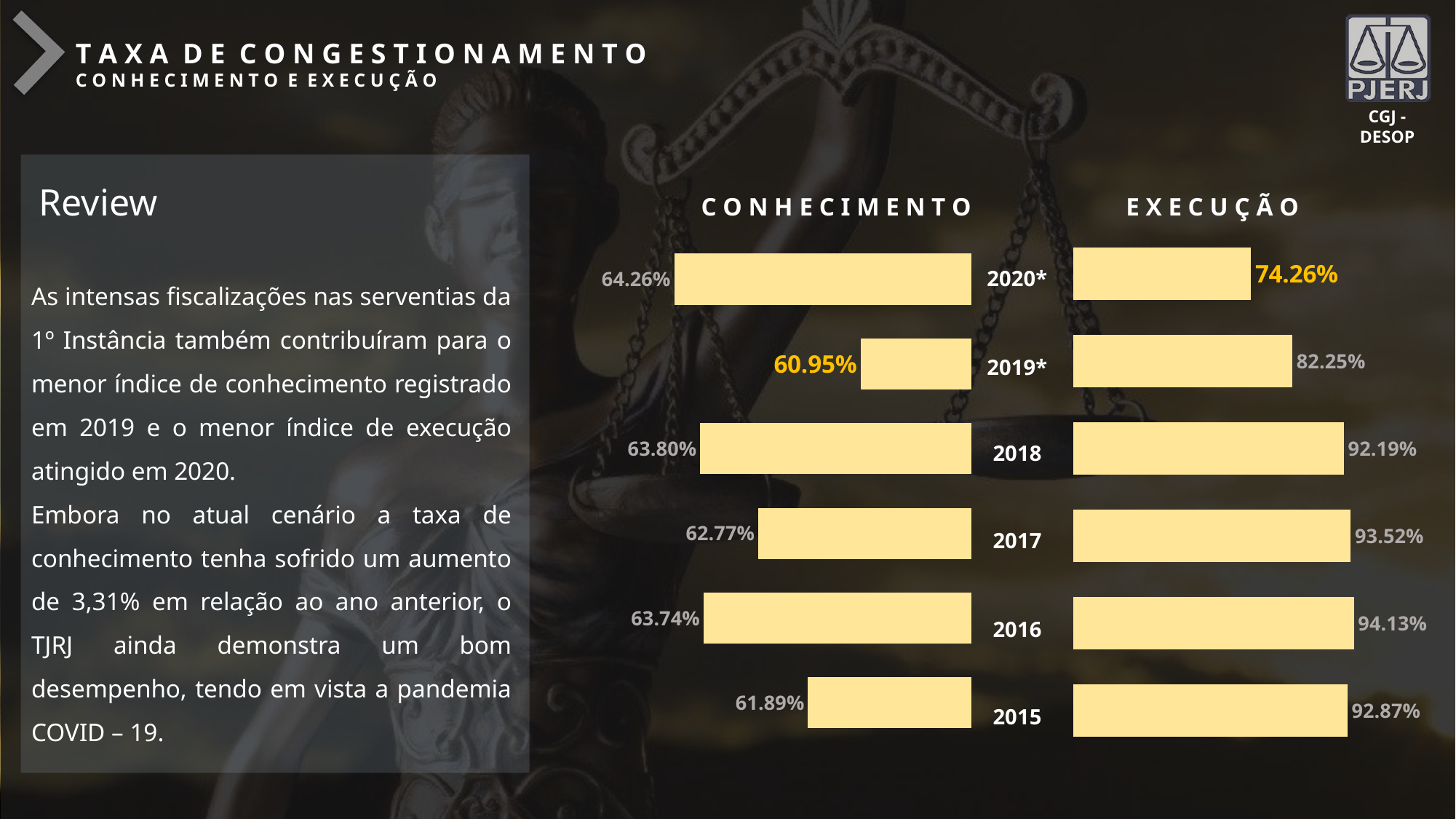
What is the CONHECIMENTO value for 2020*? 64.26% Which is larger, the CONHECIMENTO value for 2018 or for 2017? 2018 What is the difference between the EXECUÇÃO values for 2019* and 2020*? 7.99% Which year has the highest EXECUÇÃO value? 2016 What type of chart is shown on the slide? Bar chart What is the difference between the CONHECIMENTO values for 2020* and 2019*? 3.31% What is the EXECUÇÃO value for 2017? 93.52% What is the EXECUÇÃO value for 2019*? 82.25% What is the CONHECIMENTO value for 2015? 61.89% How many years are shown in the chart? 6 Which year has the lowest EXECUÇÃO value? 2020* Which year has the lowest CONHECIMENTO value? 2019*